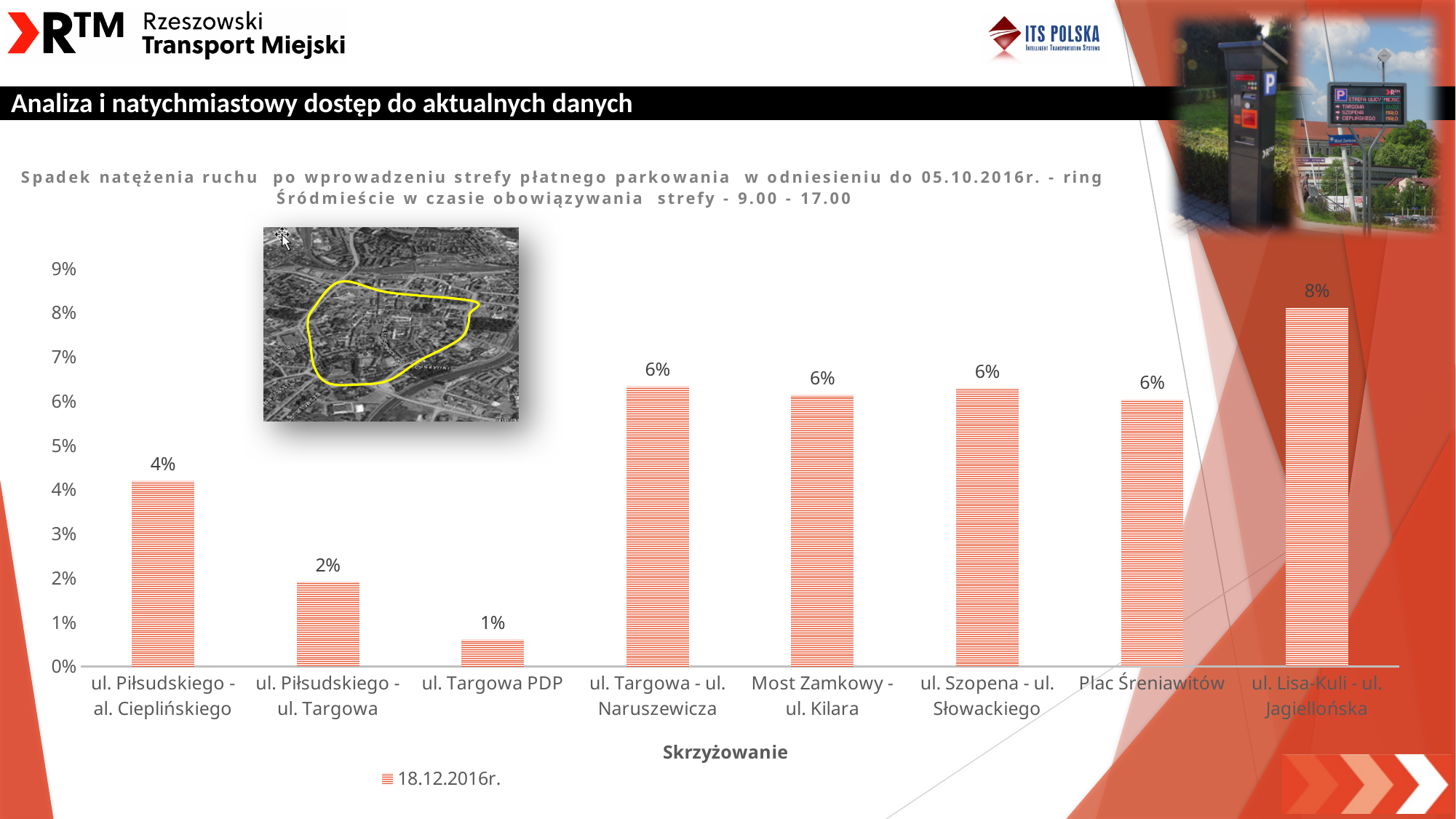
Which intersection has the lowest value? ul. Targowa PDP How many series does the legend list? 1 What is the value for ul. Piłsudskiego - al. Cieplińskiego? 4% Which is larger: the value for ul. Piłsudskiego - al. Cieplińskiego or for ul. Piłsudskiego - ul. Targowa? ul. Piłsudskiego - al. Cieplińskiego Is the value for ul. Targowa - ul. Naruszewicza greater or less than 5%? greater What is the value for ul. Lisa-Kuli - ul. Jagiellońska? 8% What is the value for Most Zamkowy - ul. Kilara? 6% How many intersections are shown on the x axis? 8 What is the difference between the values for ul. Lisa-Kuli - ul. Jagiellońska and ul. Piłsudskiego - al. Cieplińskiego? 4% Which intersection has the highest value? ul. Lisa-Kuli - ul. Jagiellońska What kind of chart is shown on the slide? bar chart What is the value for ul. Targowa PDP? 1%